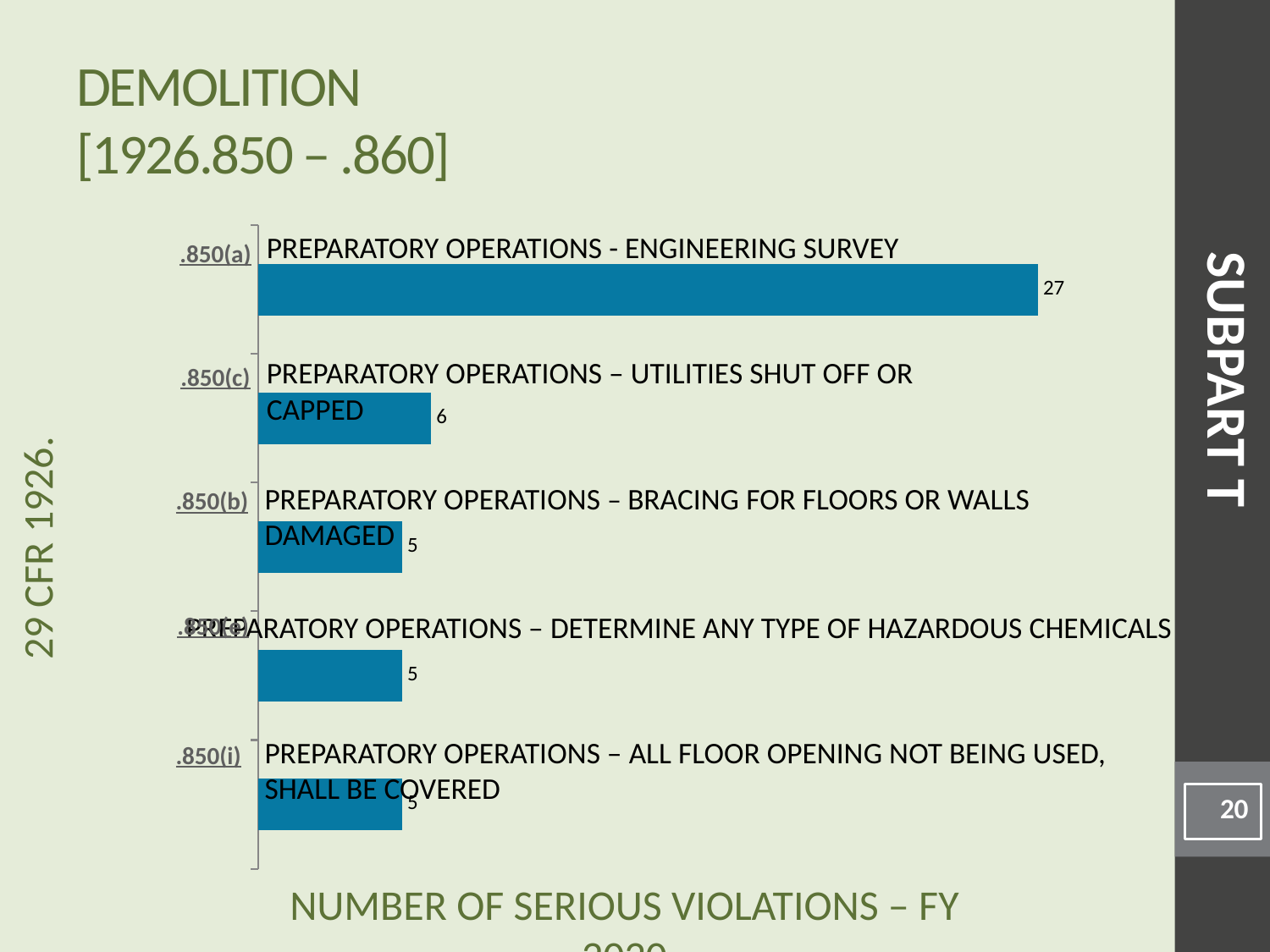
What kind of chart is shown on the slide? Bar chart What is the value for .850(b) Preparatory Operations – Bracing for Floors or Walls Damaged? 5 Which standard has the highest number of serious violations? .850(a) What is the value for .850(i) Preparatory Operations – All Floor Opening Not Being Used, Shall Be Covered? 5 What is the value for .850(c) Preparatory Operations – Utilities Shut Off or Capped? 6 How many serious violations are shown for .850(a) Preparatory Operations - Engineering Survey? 27 What is the difference between the values for .850(a) and .850(c)? 21 What is the value for the bar labelled Preparatory Operations – Determine Any Type of Hazardous Chemicals? 5 What is the difference between the values for .850(a) and .850(b)? 22 How many standards (bars) are shown in the chart? 5 What colour are the bars in the chart? Blue Which has a larger value, .850(c) or .850(b)? .850(c)